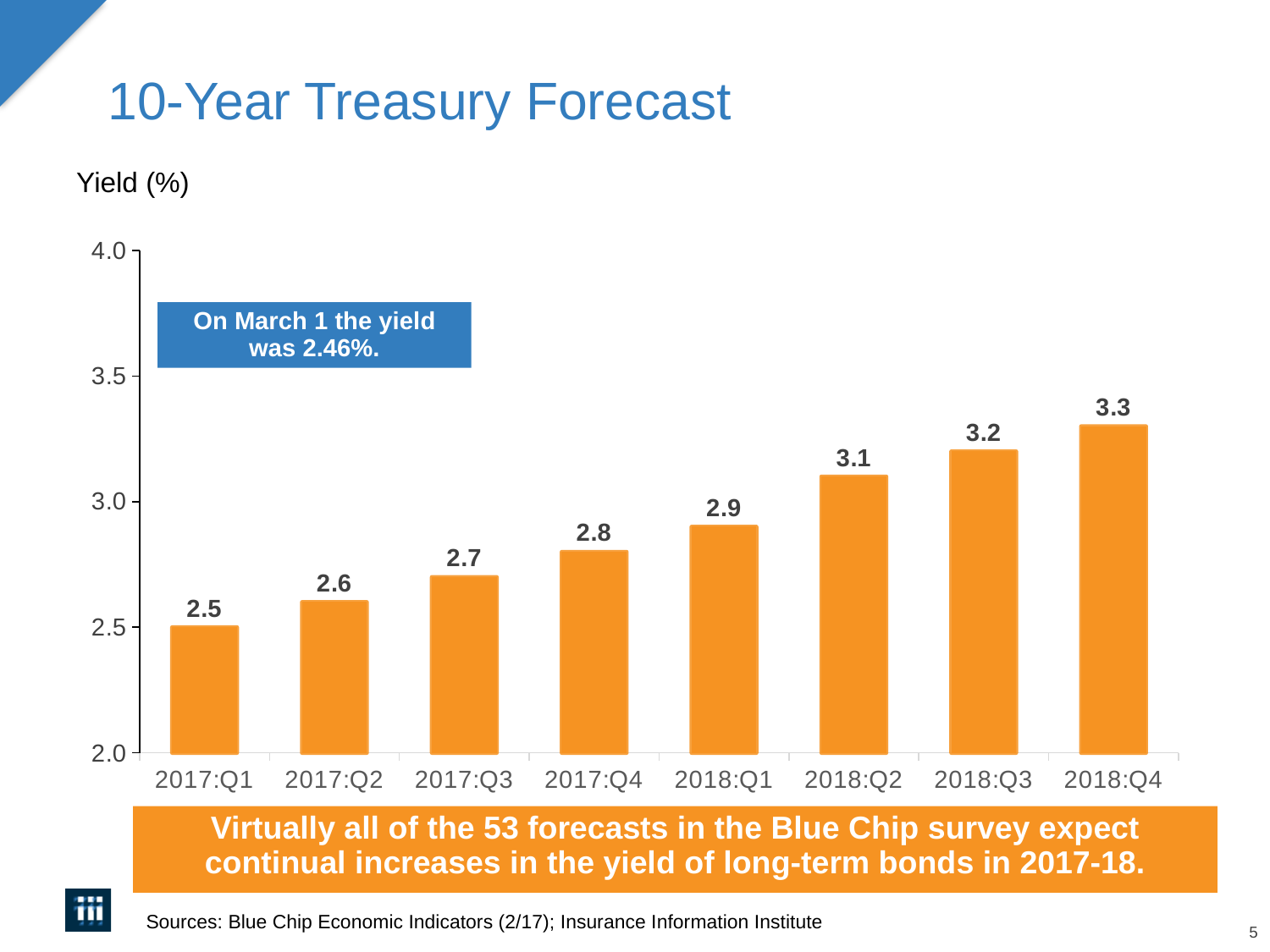
What is the forecast yield for 2018:Q2? 3.1 What is the forecast yield for 2017:Q4? 2.8 Which quarter has the lowest forecast yield? 2017:Q1 What kind of chart is shown on the slide? Bar chart Which is larger, the forecast yield for 2018:Q1 or 2017:Q3? 2018:Q1 What is the difference between the forecast yield for 2018:Q4 and 2017:Q1? 0.8 Is the forecast yield for 2018:Q3 greater or less than 3.0? greater How many quarters are shown on the chart? 8 Do the forecast yields rise or fall from 2017:Q1 to 2018:Q4? Rise According to the callout box on the chart, what was the yield on March 1? 2.46% What is the forecast 10-year Treasury yield for 2017:Q1? 2.5 Which quarter has the highest forecast yield? 2018:Q4